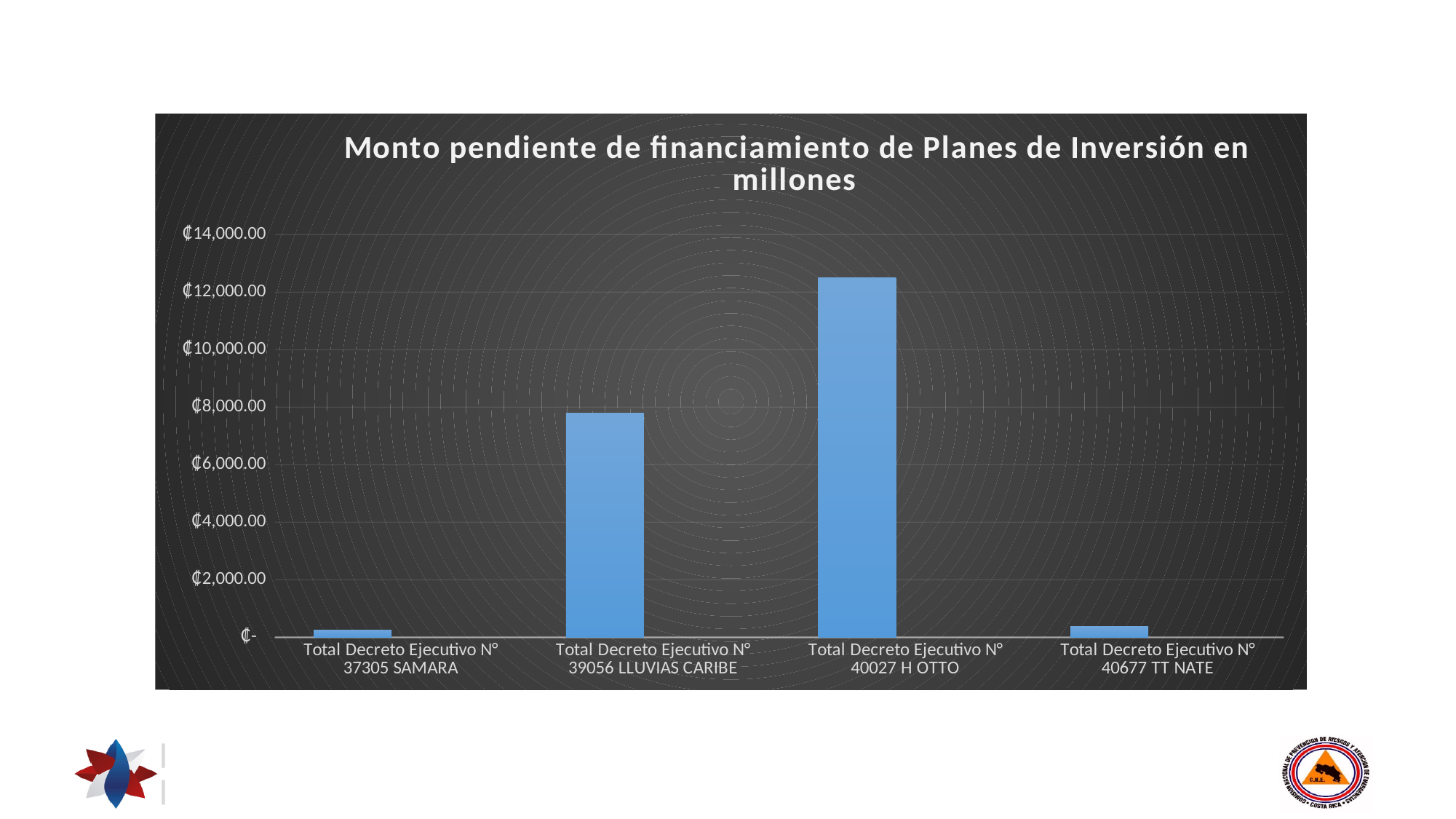
Is the value for Total Decreto Ejecutivo N° 39056 LLUVIAS CARIBE greater or less than ₡8,000.00? less Is the value for Total Decreto Ejecutivo N° 37305 SAMARA greater or less than ₡2,000.00? less Which category has the highest value in the chart? Total Decreto Ejecutivo N° 40027 H OTTO Is the value for Total Decreto Ejecutivo N° 40677 TT NATE greater or less than ₡2,000.00? less What is the highest value shown on the vertical axis of the chart? ₡14,000.00 Which is larger, the value for Total Decreto Ejecutivo N° 39056 LLUVIAS CARIBE or for Total Decreto Ejecutivo N° 40027 H OTTO? Total Decreto Ejecutivo N° 40027 H OTTO How many categories are plotted in the chart? 4 What kind of chart is shown on the slide? bar chart What is the title of the chart? Monto pendiente de financiamiento de Planes de Inversión en millones Which is larger, the value for Total Decreto Ejecutivo N° 37305 SAMARA or for Total Decreto Ejecutivo N° 39056 LLUVIAS CARIBE? Total Decreto Ejecutivo N° 39056 LLUVIAS CARIBE